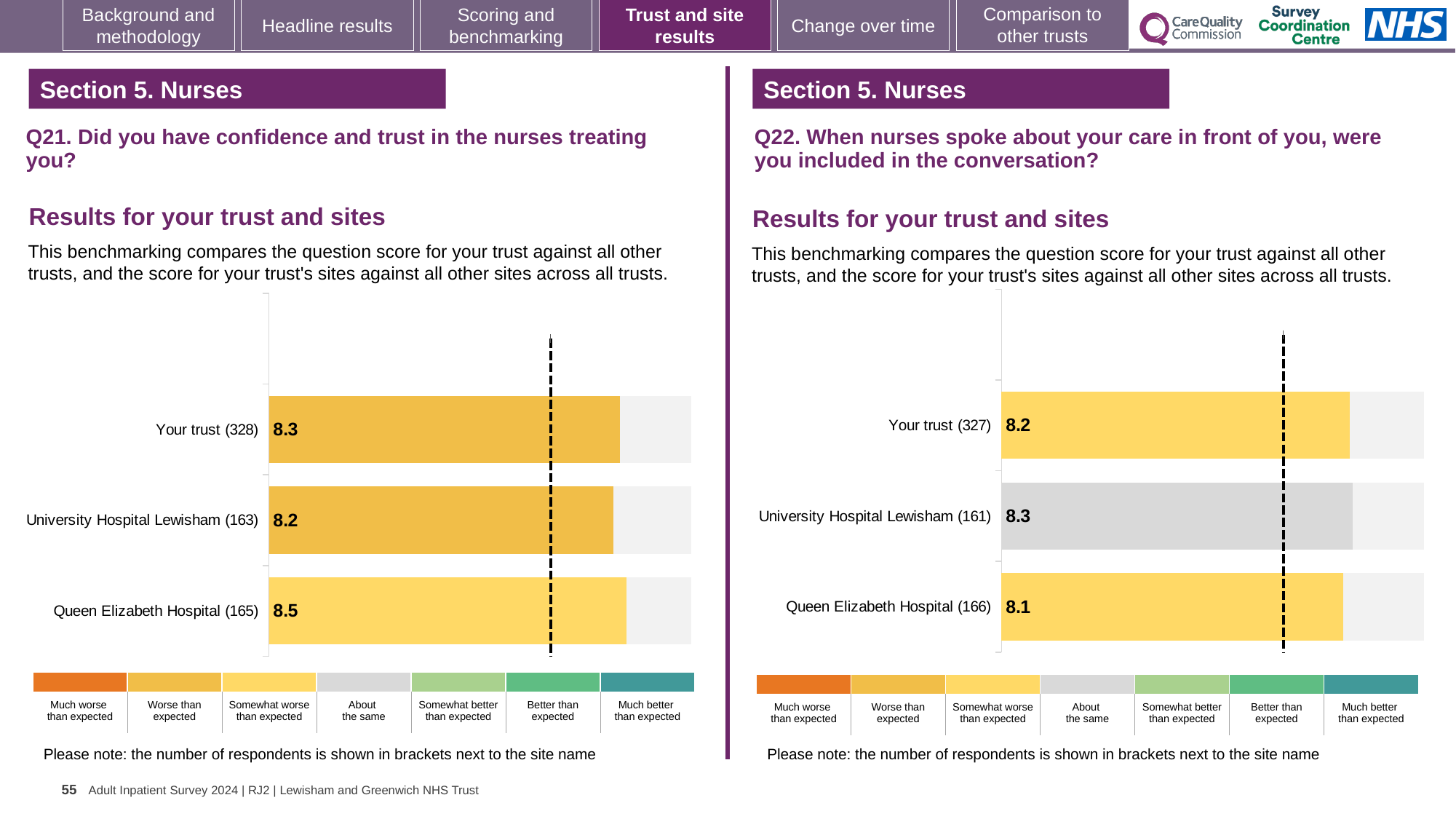
In the Q22 chart on the right, which benchmark category does the colour of the University Hospital Lewisham bar correspond to? About the same How many bars are plotted in the Q22 chart on the right? 3 In the Q21 chart on the left, what is the score for Your trust (328)? 8.3 In the Q21 chart on the left, which site or trust has the lowest score? University Hospital Lewisham (163) In the Q22 chart on the right, which site or trust has the highest score? University Hospital Lewisham (161) In the Q22 chart on the right, what is the score for University Hospital Lewisham (161)? 8.3 In the Q22 chart on the right, what is the score for Queen Elizabeth Hospital (166)? 8.1 In the Q21 chart on the left, what is the score for Queen Elizabeth Hospital (165)? 8.5 In the Q21 chart on the left, what is the difference between the scores for Queen Elizabeth Hospital and University Hospital Lewisham? 0.3 In the Q21 chart on the left, which site or trust has the highest score? Queen Elizabeth Hospital (165) In the Q22 chart on the right, which is larger: the score for Your trust or the score for Queen Elizabeth Hospital? Your trust What type of chart is used for the Q21 results on the left? Bar chart